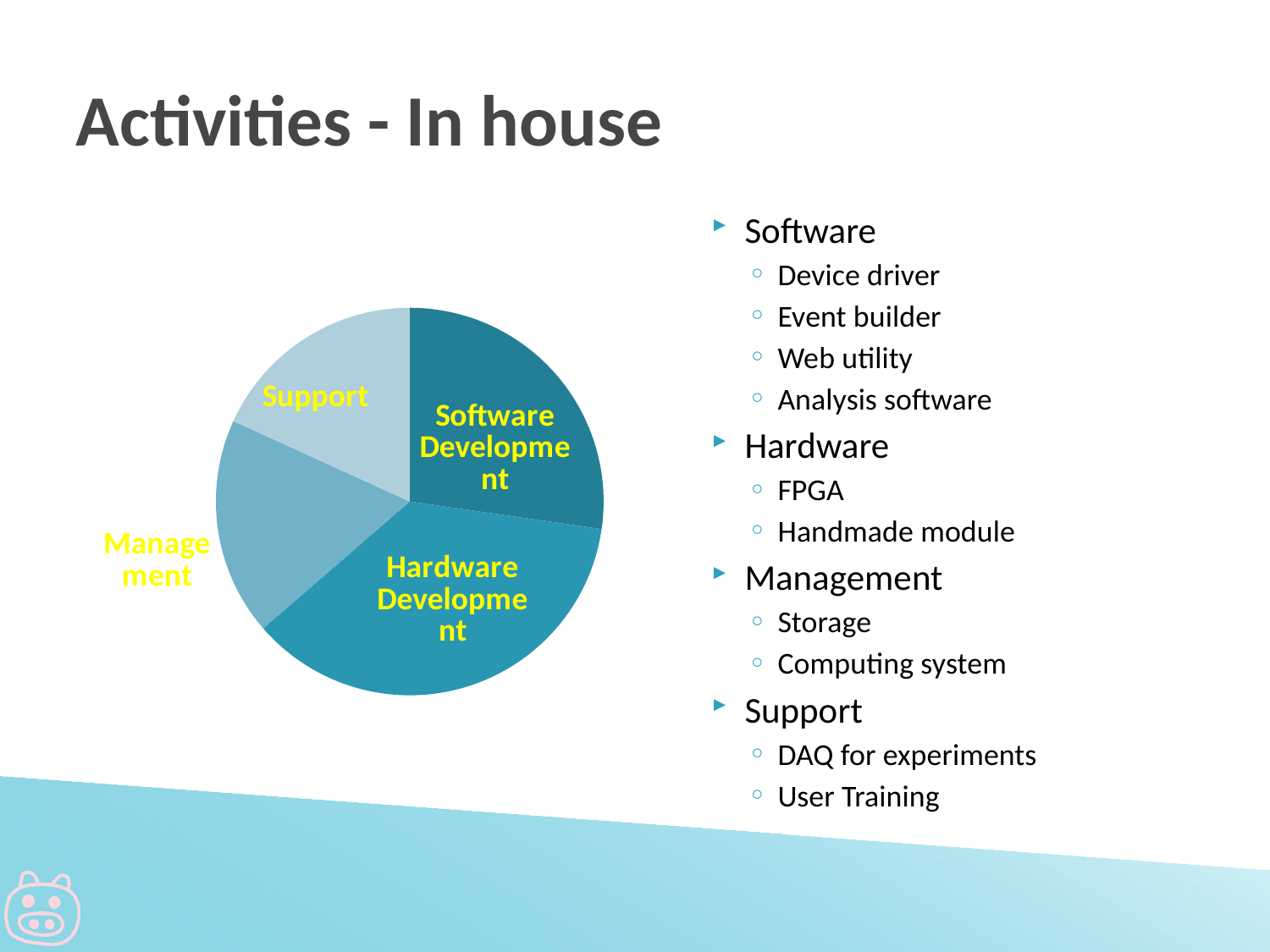
Which slice is larger, Hardware Development or Management? Hardware Development Which category has the largest slice in the pie chart? Hardware Development How many slices does the pie chart have? 4 What colour is the text of the slice labels in the pie chart? yellow What are the four categories labelled in the pie chart? Software Development, Hardware Development, Management, Support Which slice is larger, Hardware Development or Software Development? Hardware Development Which slice is larger, Software Development or Support? Software Development What kind of chart is shown on the slide? pie chart